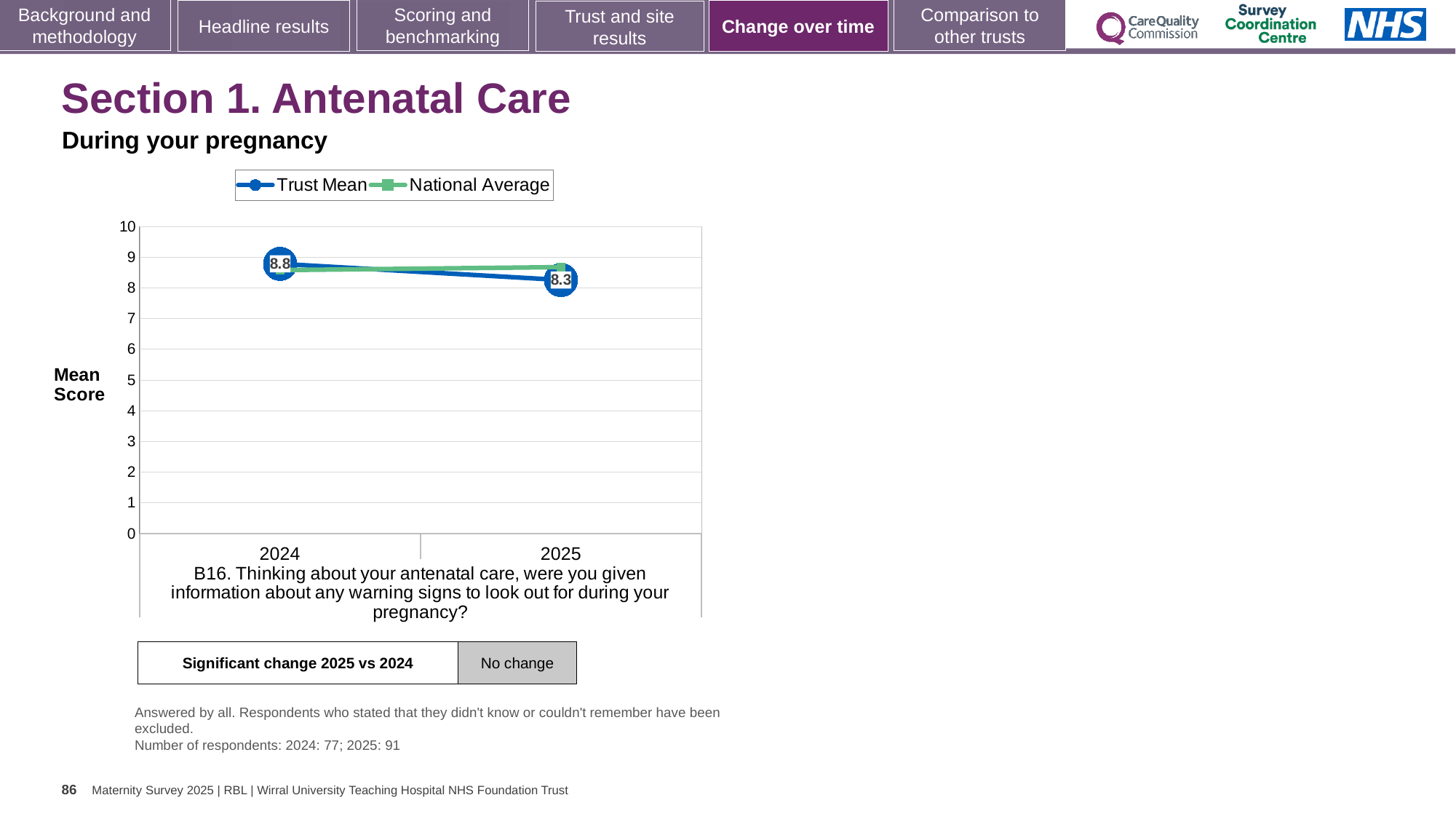
What is the Trust Mean score for 2024? 8.8 How many series does the legend list? 2 What is the label on the y axis of the chart? Mean Score In which year is the Trust Mean score at its lowest? 2025 Does the Trust Mean score rise or fall from 2024 to 2025? fall How many years are plotted on the x axis? 2 Is the National Average value for 2025 greater or less than 7? greater What kind of chart is shown on the slide? line chart By how much did the Trust Mean score change from 2024 to 2025? 0.5 What is the Trust Mean score for 2025? 8.3 Is the National Average value for 2024 greater or less than 8? greater Which year has the higher Trust Mean score, 2024 or 2025? 2024